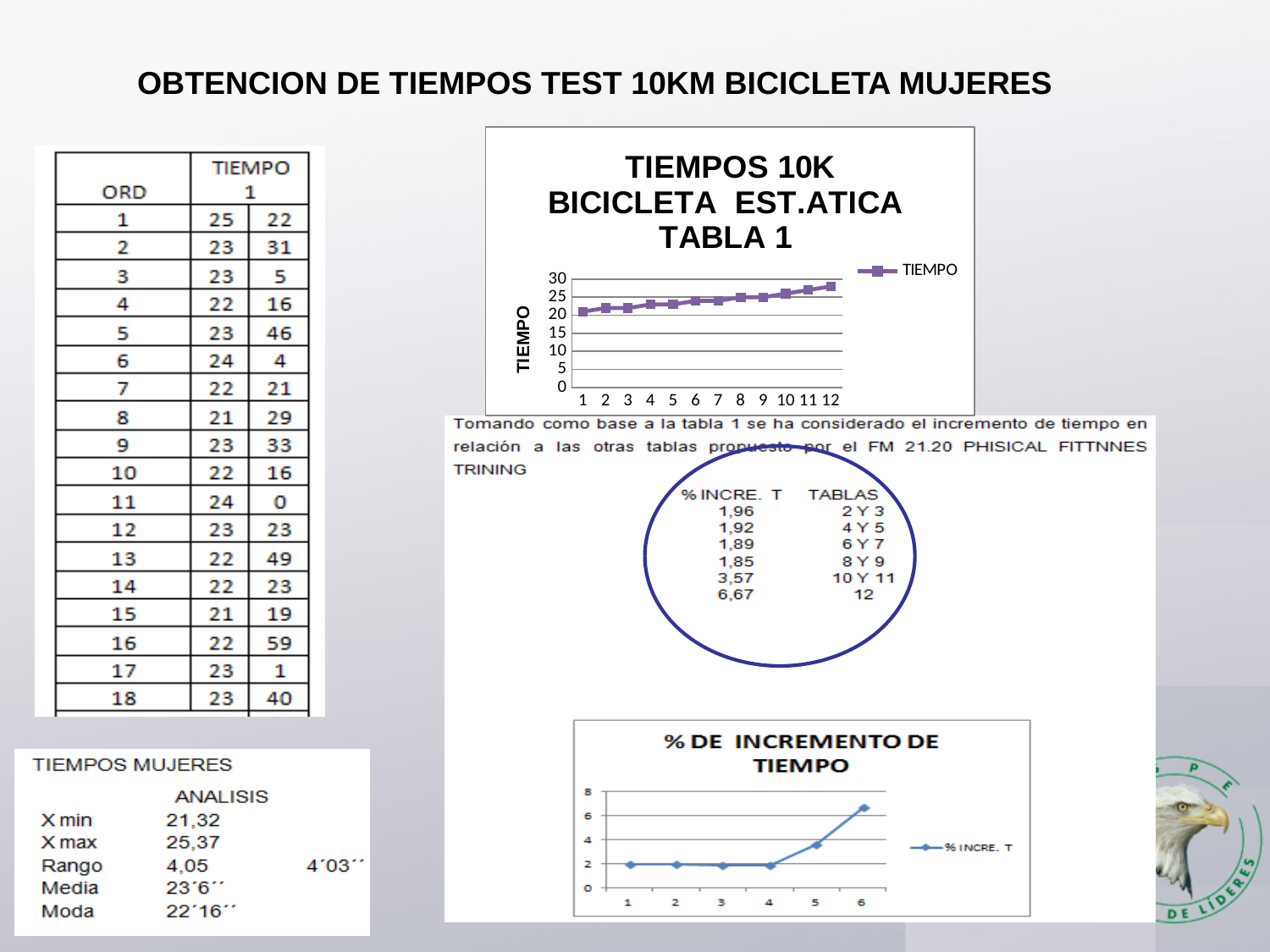
In the chart titled "TIEMPOS 10K BICICLETA EST.ATICA TABLA 1", how many series does the legend list? 1 In the chart titled "TIEMPOS 10K BICICLETA EST.ATICA TABLA 1", do the values rise or fall from point 1 to point 12? rise In the chart titled "TIEMPOS 10K BICICLETA EST.ATICA TABLA 1", what is the title of the vertical axis? TIEMPO In the chart titled "% DE INCREMENTO DE TIEMPO", which point has the highest value? 6 In the chart titled "TIEMPOS 10K BICICLETA EST.ATICA TABLA 1", how many points are plotted along the x axis? 12 In the chart titled "TIEMPOS 10K BICICLETA EST.ATICA TABLA 1", what kind of chart is shown? line chart In the chart titled "% DE INCREMENTO DE TIEMPO", what series name does the legend show? % INCRE. T In the chart titled "% DE INCREMENTO DE TIEMPO", how many points are plotted along the x axis? 6 In the chart titled "TIEMPOS 10K BICICLETA EST.ATICA TABLA 1", is the value at point 1 greater or less than 25? less In the chart titled "% DE INCREMENTO DE TIEMPO", is the value at point 5 greater or less than 2? greater In the chart titled "TIEMPOS 10K BICICLETA EST.ATICA TABLA 1", is the value at point 12 greater or less than 25? greater In the chart titled "% DE INCREMENTO DE TIEMPO", what kind of chart is shown? line chart